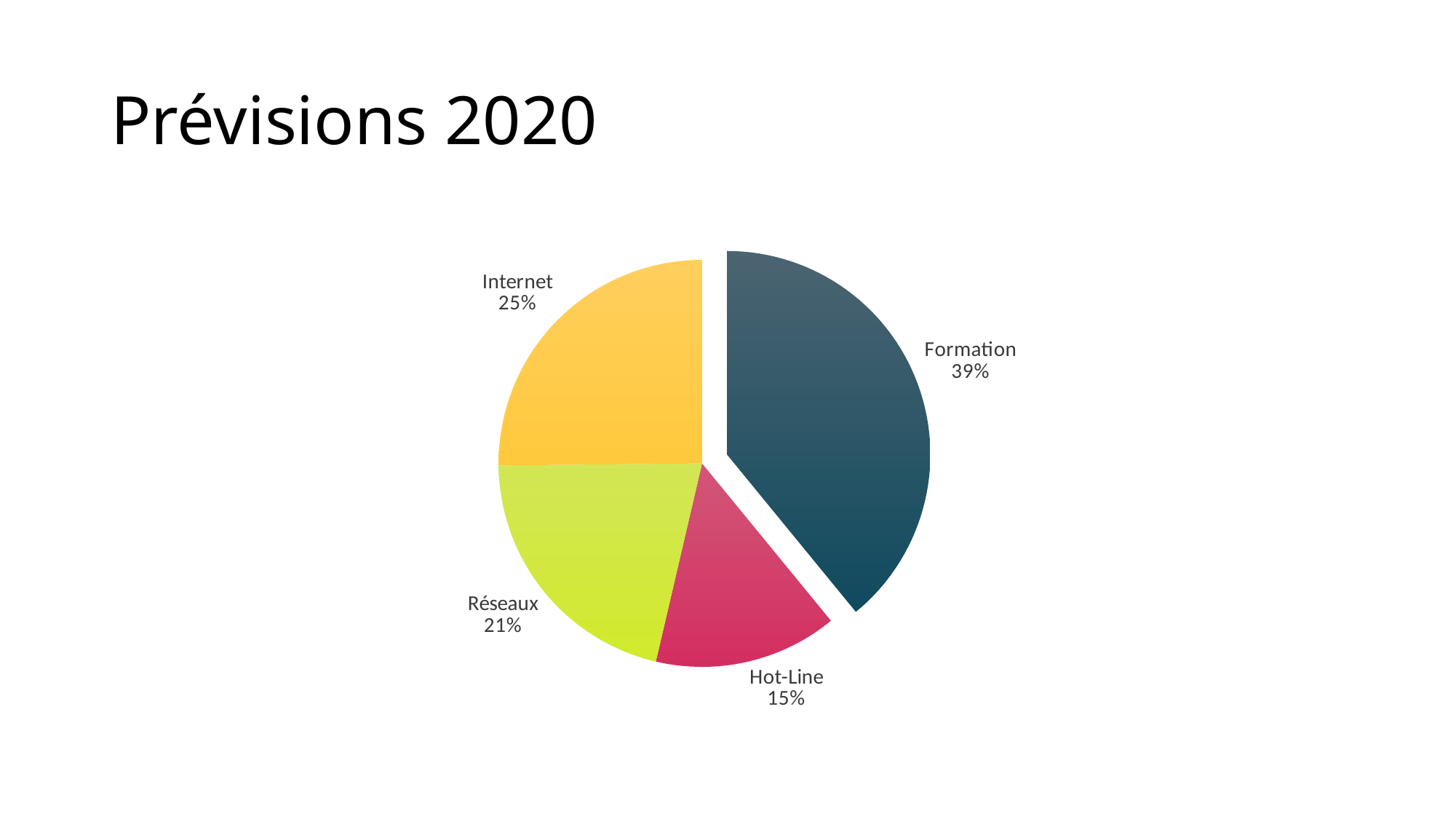
How many categories are shown in the pie chart? 4 What is the value shown for Internet? 25% Which category has the smallest slice of the pie? Hot-Line What is the difference between the Internet and Réseaux shares? 4% What is the value shown for Réseaux? 21% What share of the pie does Formation represent? 39% What is the value shown for Hot-Line? 15% What is the difference between the Formation and Hot-Line shares? 24% Which category has the largest slice of the pie? Formation Which is larger, the share for Internet or the share for Réseaux? Internet What is the title of the slide containing the pie chart? Prévisions 2020 What kind of chart is shown on the slide? pie chart